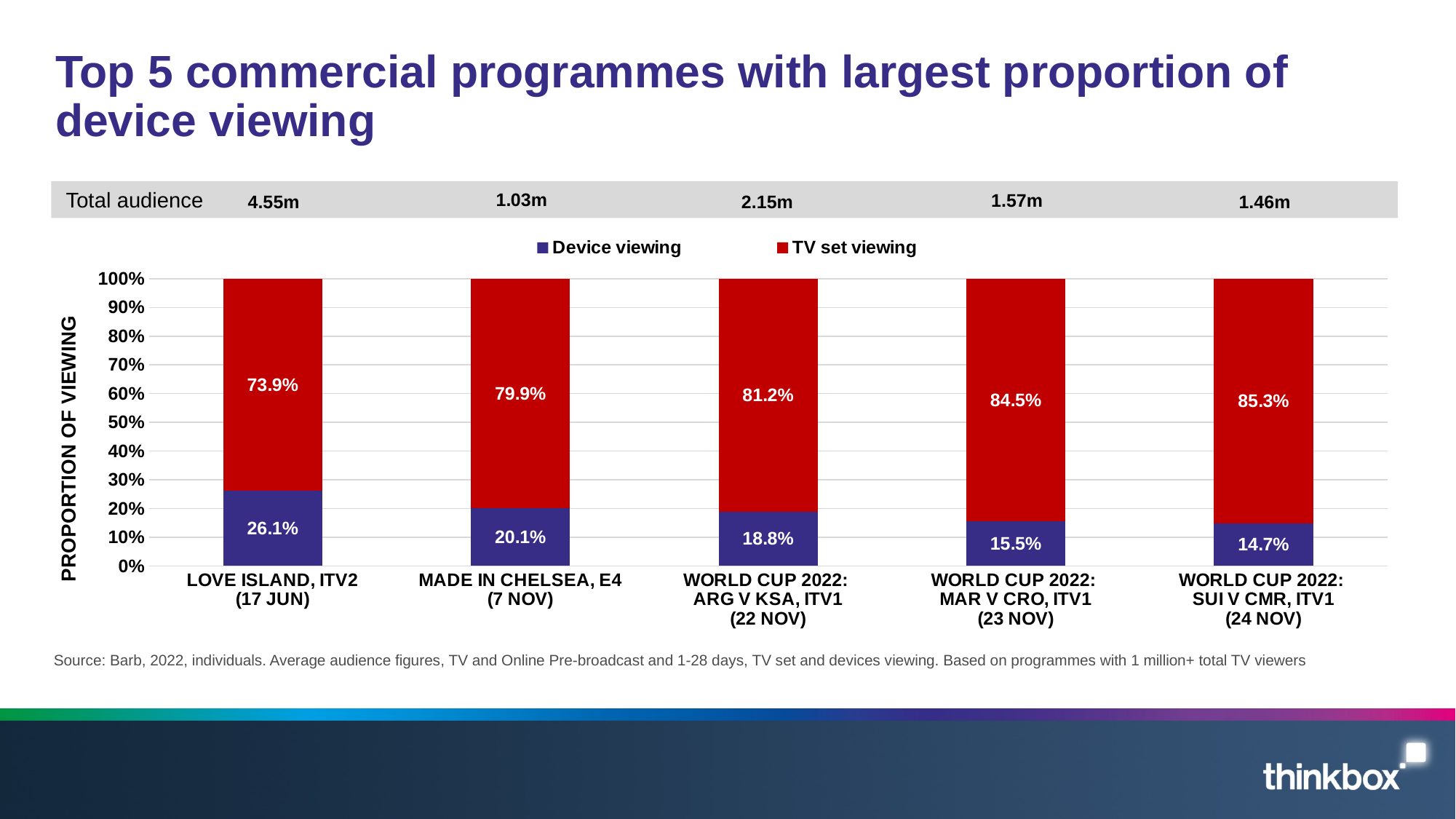
What is the total audience shown for WORLD CUP 2022: ARG V KSA, ITV1 (22 NOV)? 2.15m Does the Device viewing proportion rise or fall from left to right across the programmes? Fall Which has a larger Device viewing proportion: WORLD CUP 2022: ARG V KSA, ITV1 (22 NOV) or WORLD CUP 2022: MAR V CRO, ITV1 (23 NOV)? WORLD CUP 2022: ARG V KSA, ITV1 (22 NOV) How many series does the legend list? 2 Which programme has the highest Device viewing proportion? LOVE ISLAND, ITV2 (17 JUN) What is the Device viewing value for MADE IN CHELSEA, E4 (7 NOV)? 20.1% What is the Device viewing value for LOVE ISLAND, ITV2 (17 JUN)? 26.1% Which programme has the lowest Device viewing proportion? WORLD CUP 2022: SUI V CMR, ITV1 (24 NOV) What kind of chart is shown on the slide? Stacked bar chart What is the TV set viewing value for WORLD CUP 2022: SUI V CMR, ITV1 (24 NOV)? 85.3% What is the difference between the TV set viewing values for WORLD CUP 2022: MAR V CRO, ITV1 (23 NOV) and LOVE ISLAND, ITV2 (17 JUN)? 10.6% How many programmes are shown on the chart? 5